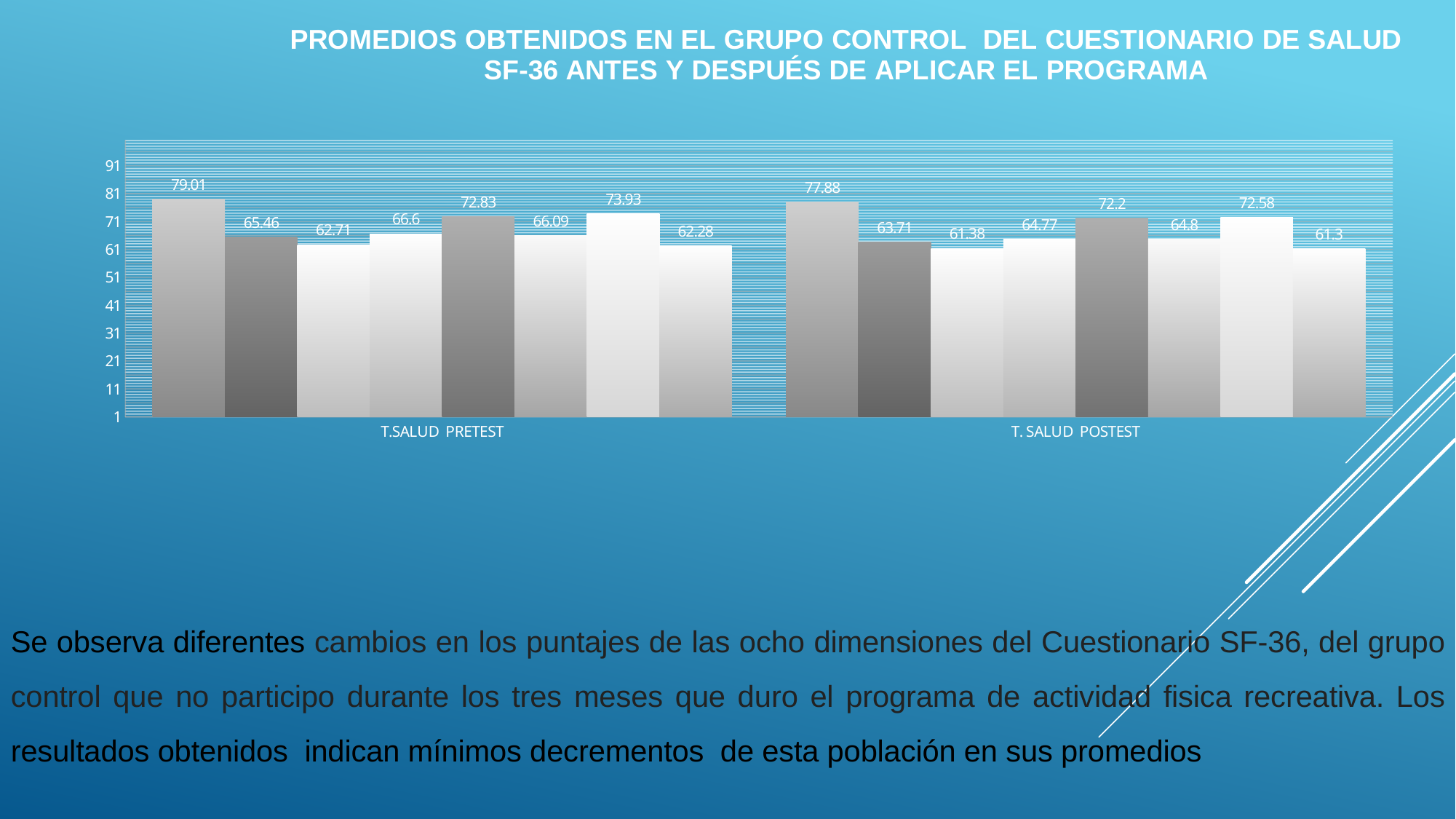
What type of chart is shown on the slide? bar chart Which bar has the highest value in the T.SALUD PRETEST group? the first bar (79.01) What is the difference between the first bar of T.SALUD PRETEST (79.01) and the first bar of T. SALUD POSTEST (77.88)? 1.13 What is the value of the first (leftmost) bar in the T. SALUD POSTEST group? 77.88 What is the value of the seventh bar in the T.SALUD PRETEST group? 73.93 How many categories are shown on the x axis of the chart? 2 Which bar has the lowest value in the T. SALUD POSTEST group? the last bar (61.3) Which is larger: the third bar in T.SALUD PRETEST or the third bar in T. SALUD POSTEST? T.SALUD PRETEST (62.71) How many bars are plotted in each category group? 8 What is the value of the first (leftmost) bar in the T.SALUD PRETEST group? 79.01 What is the value of the fifth bar in the T. SALUD POSTEST group? 72.2 What is the title of the chart? PROMEDIOS OBTENIDOS EN EL GRUPO CONTROL DEL CUESTIONARIO DE SALUD SF-36 ANTES Y DESPUÉS DE APLICAR EL PROGRAMA